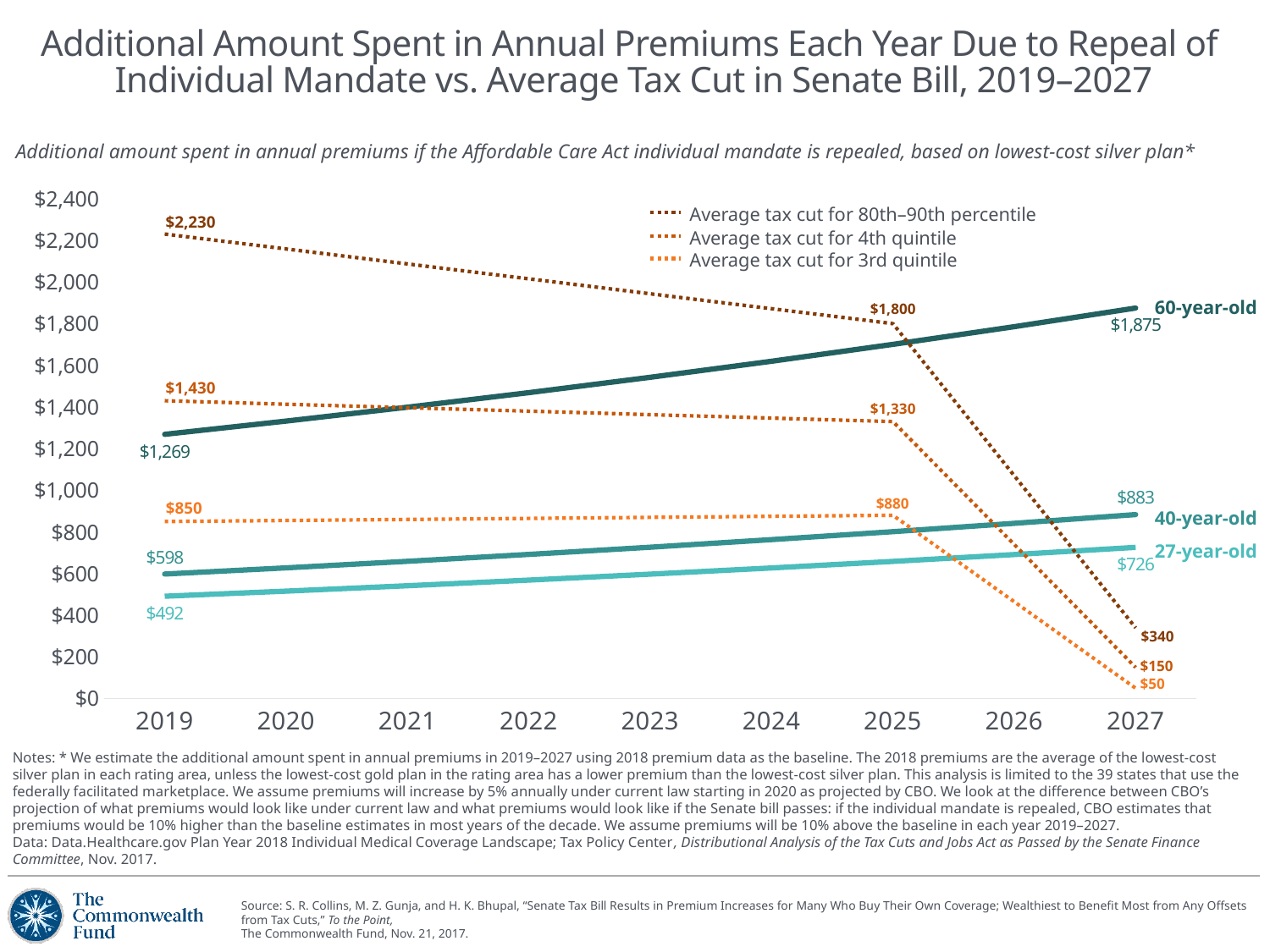
Is the value for the 60-year-old line in 2023 greater or less than $1,400? greater Which series has the highest value in 2019? Average tax cut for 80th–90th percentile What is the value for the 27-year-old line in 2027? $726 Which series has the lowest value in 2027? Average tax cut for 3rd quintile What is the average tax cut for the 80th–90th percentile in 2025? $1,800 What is the average tax cut for the 3rd quintile in 2027? $50 How many years are shown on the x axis? 9 How many series does the legend list? 3 By how much does the 60-year-old value increase from 2019 to 2027? $606 What kind of chart is shown on the slide? Line chart In 2027, which is larger: the 40-year-old value or the 27-year-old value? 40-year-old What is the additional amount spent in annual premiums for a 60-year-old in 2019? $1,269